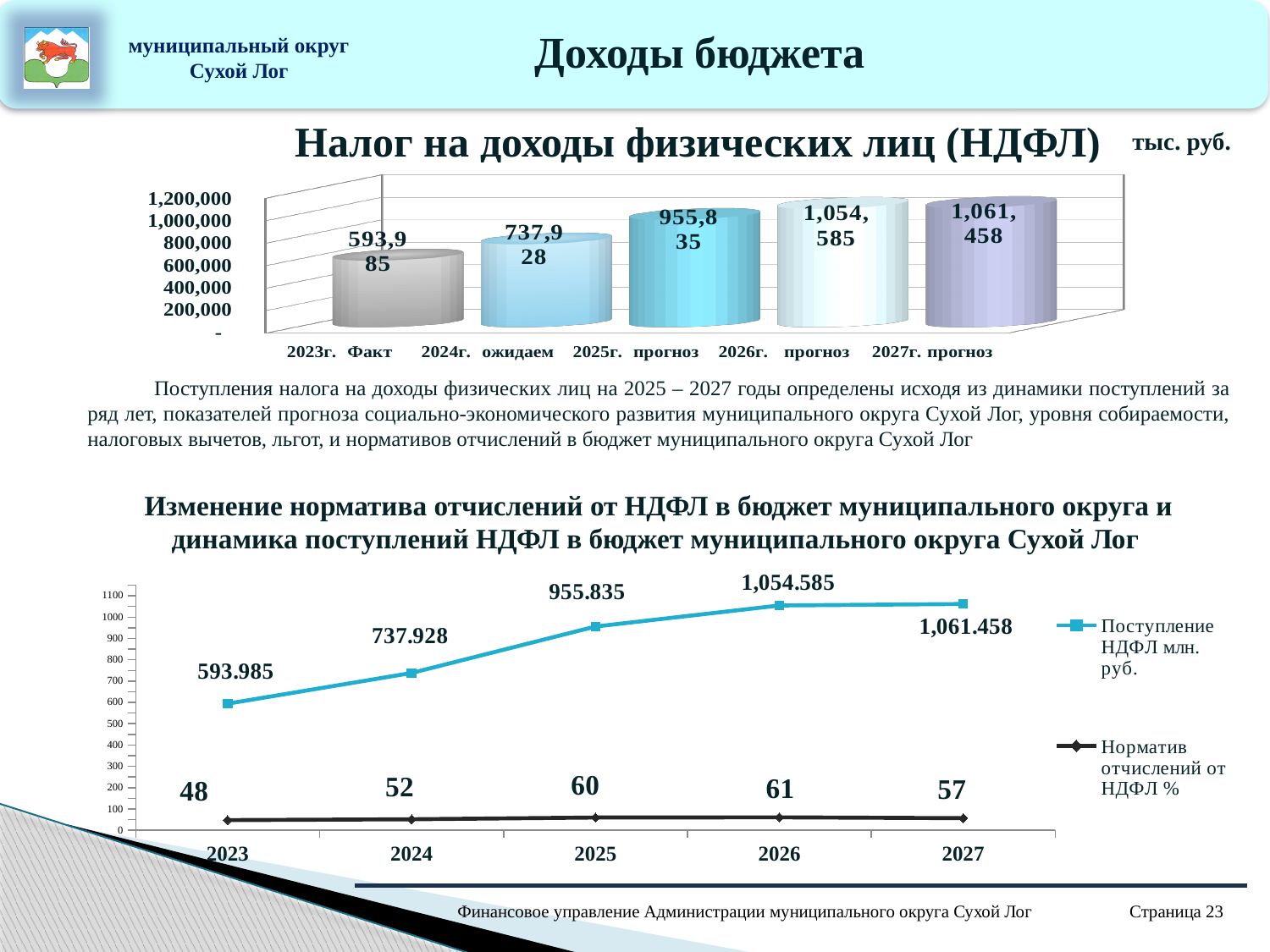
In the top chart 'Налог на доходы физических лиц (НДФЛ)', what is the difference between the 2024г. ожидаем value and the 2023г. Факт value? 143,943 In the top chart 'Налог на доходы физических лиц (НДФЛ)', what is the value for 2025г. прогноз? 955,835 What type of chart is the top chart 'Налог на доходы физических лиц (НДФЛ)'? Bar chart In the bottom line chart, what is the value of 'Норматив отчислений от НДФЛ %' for 2025? 60 In the top chart 'Налог на доходы физических лиц (НДФЛ)', which category has the highest value? 2027г. прогноз In the bottom line chart, which year has the lowest value of 'Норматив отчислений от НДФЛ %'? 2023 In the bottom line chart, does the 'Поступление НДФЛ млн. руб.' series rise or fall from 2023 to 2027? Rise In the top chart 'Налог на доходы физических лиц (НДФЛ)', how many bars are shown? 5 In the top chart 'Налог на доходы физических лиц (НДФЛ)', what is the value for 2023г. Факт? 593,985 In the top chart 'Налог на доходы физических лиц (НДФЛ)', which category has the lowest value? 2023г. Факт In the bottom line chart, what is the value of 'Поступление НДФЛ млн. руб.' for 2026? 1,054.585 In the bottom line chart, how many series does the legend list? 2